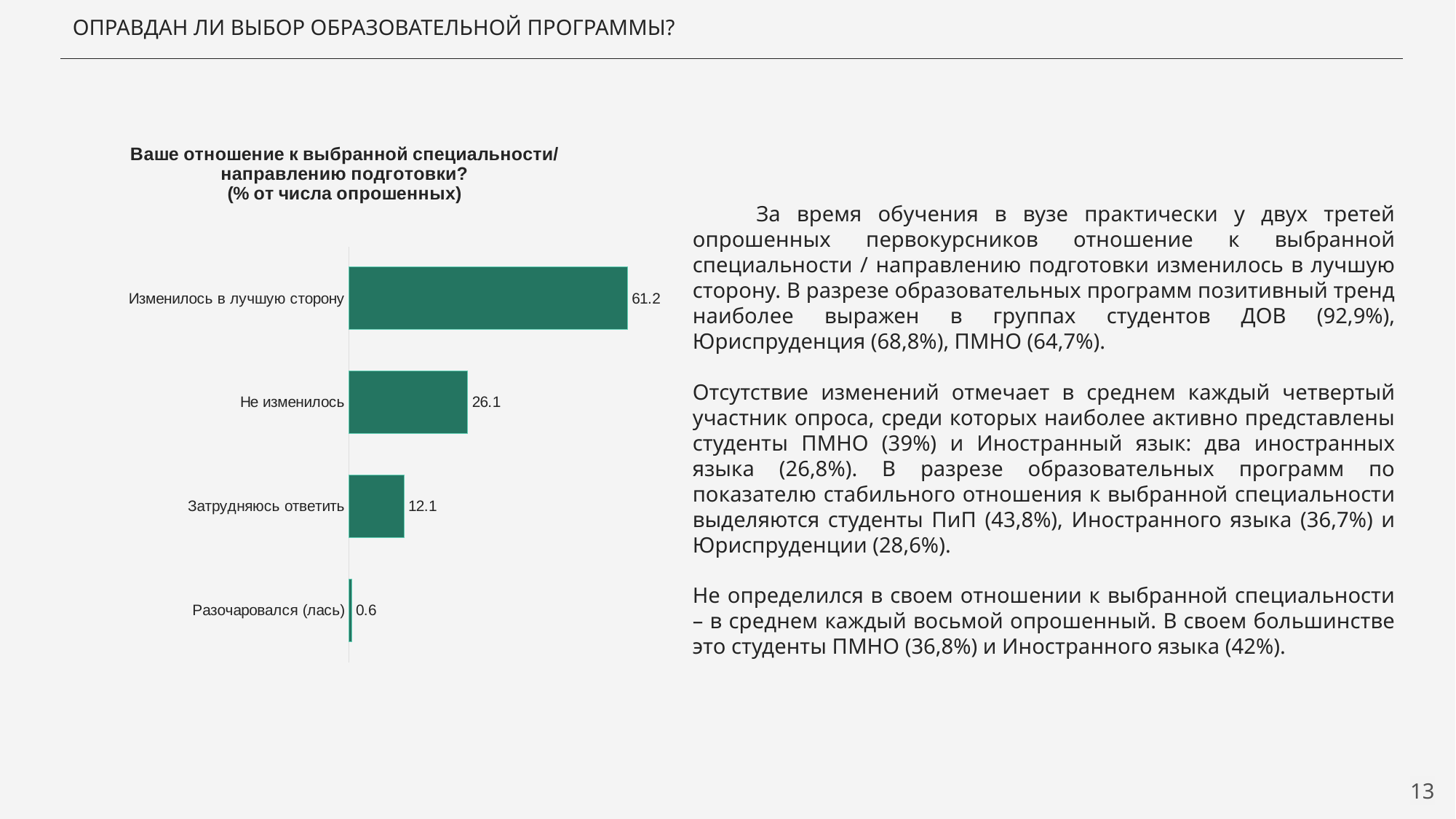
Which category has the lowest value? Разочаровался (лась) What is the difference between the values for "Изменилось в лучшую сторону" and "Не изменилось"? 35.1 What is the value for "Затрудняюсь ответить"? 12.1 Which category has the highest value? Изменилось в лучшую сторону Which is larger: the value for "Не изменилось" or the value for "Затрудняюсь ответить"? Не изменилось What is the difference between the values for "Не изменилось" and "Затрудняюсь ответить"? 14 What kind of chart is shown on the slide? Bar chart What is the value for "Не изменилось"? 26.1 How many categories are shown in the chart? 4 What is the value for "Изменилось в лучшую сторону"? 61.2 What is the value for "Разочаровался (лась)"? 0.6 What is the title of the chart? Ваше отношение к выбранной специальности/ направлению подготовки? (% от числа опрошенных)